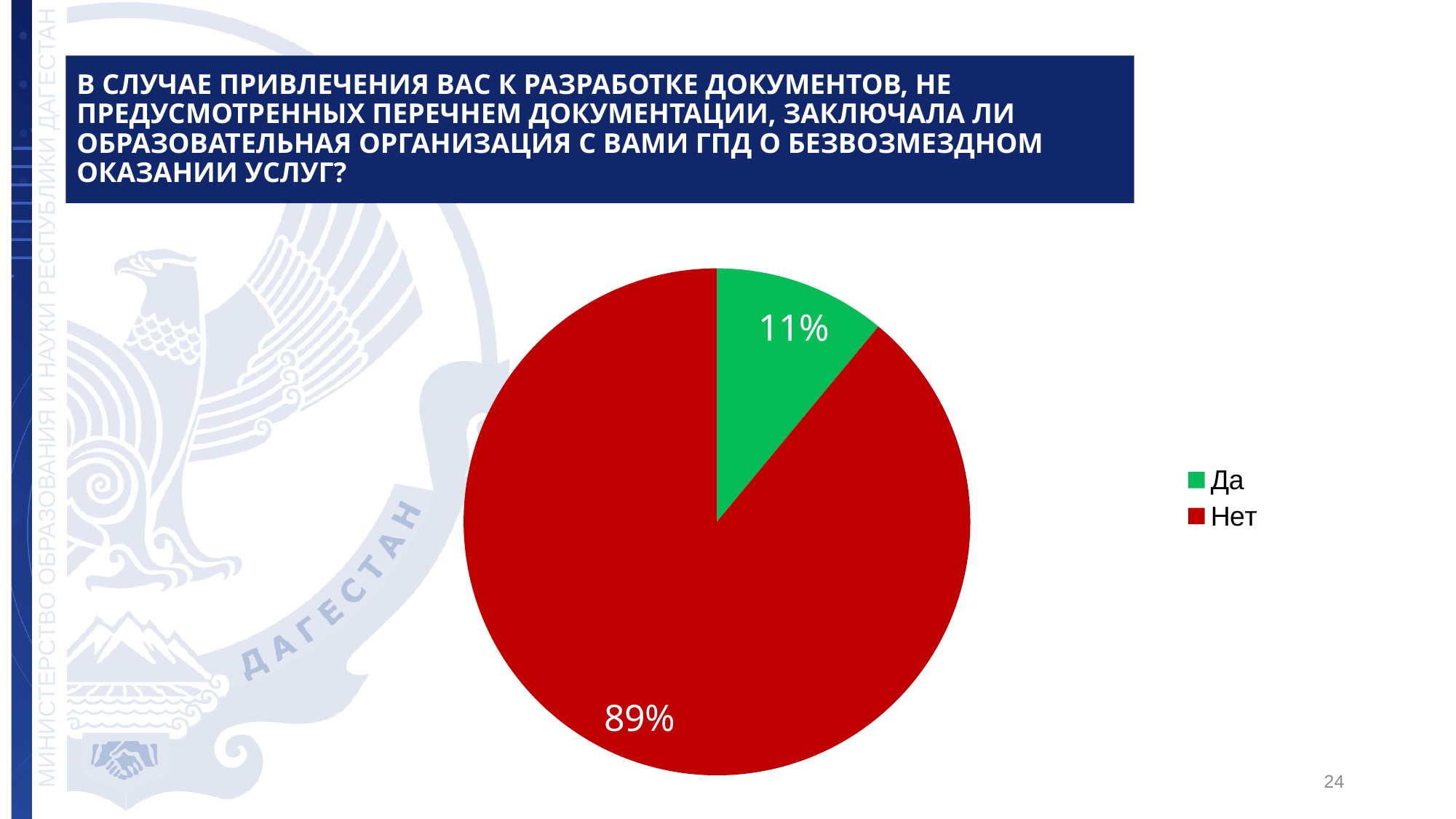
Is the share for "Нет" greater or less than 50%? greater How many slices does the pie chart have? 2 What share of the pie does "Нет" represent? 89% Which is larger, the "Да" slice or the "Нет" slice? Нет How many entries does the legend list? 2 What colour is the "Нет" slice? red What kind of chart is shown on the slide? pie chart What colour is the "Да" slice? green What share of the pie does "Да" represent? 11% Which slice of the pie is the largest? Нет Which slice of the pie is the smallest? Да What is the difference in percentage points between the "Нет" and "Да" slices? 78